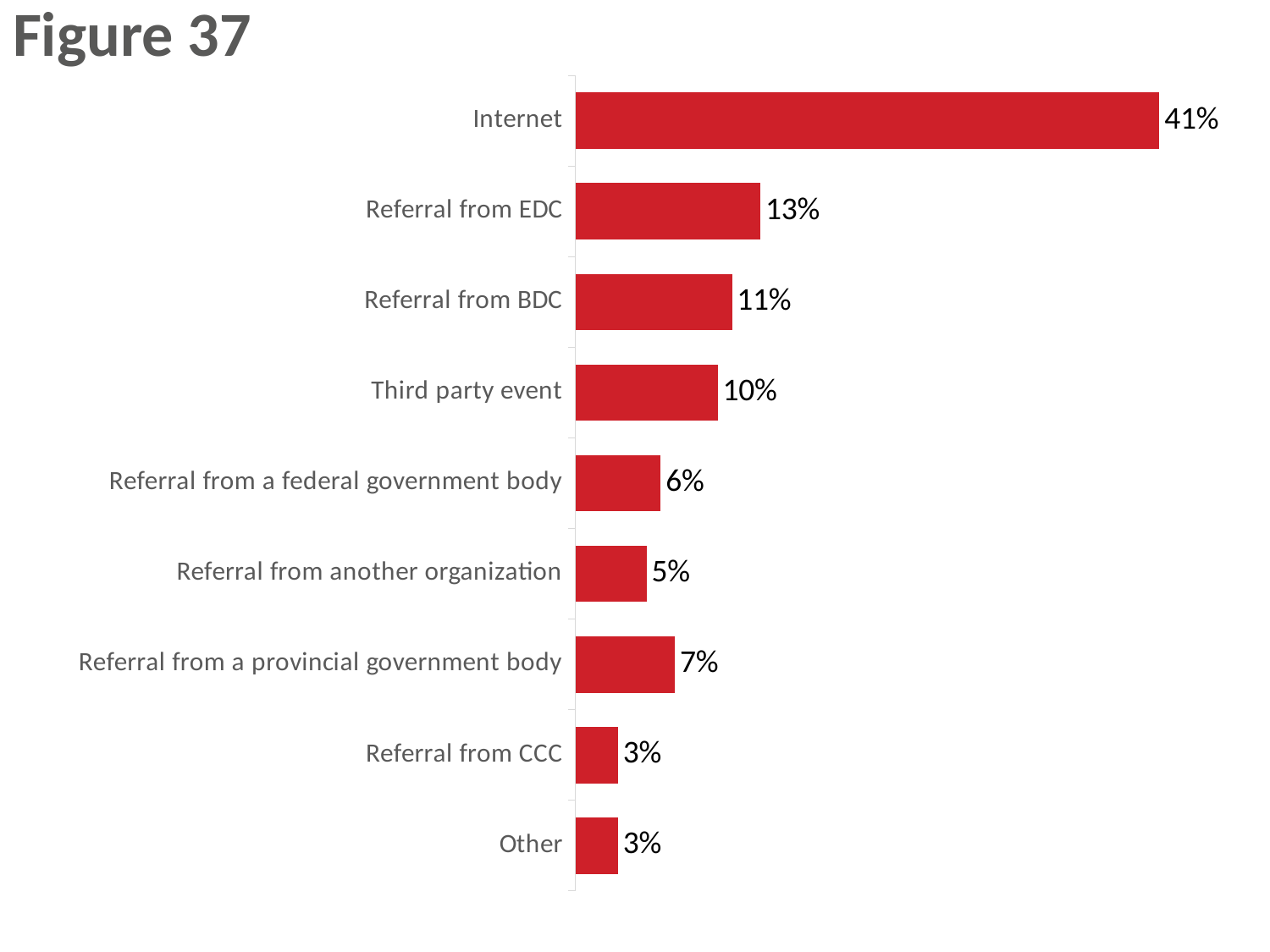
What is the difference between the values for Referral from BDC and Referral from a federal government body? 5% What is the value for Internet? 41% Which is larger, the value for Referral from EDC or the value for Referral from BDC? Referral from EDC What is the value for Referral from EDC? 13% What is the title of the slide? Figure 37 What kind of chart is shown on the slide? Bar chart What is the difference between the values for Internet and Referral from EDC? 28% Which is larger, the value for Referral from a provincial government body or the value for Referral from another organization? Referral from a provincial government body What is the value for Third party event? 10% How many categories are shown in the chart? 9 What is the value for Referral from a provincial government body? 7% Which category has the highest value? Internet